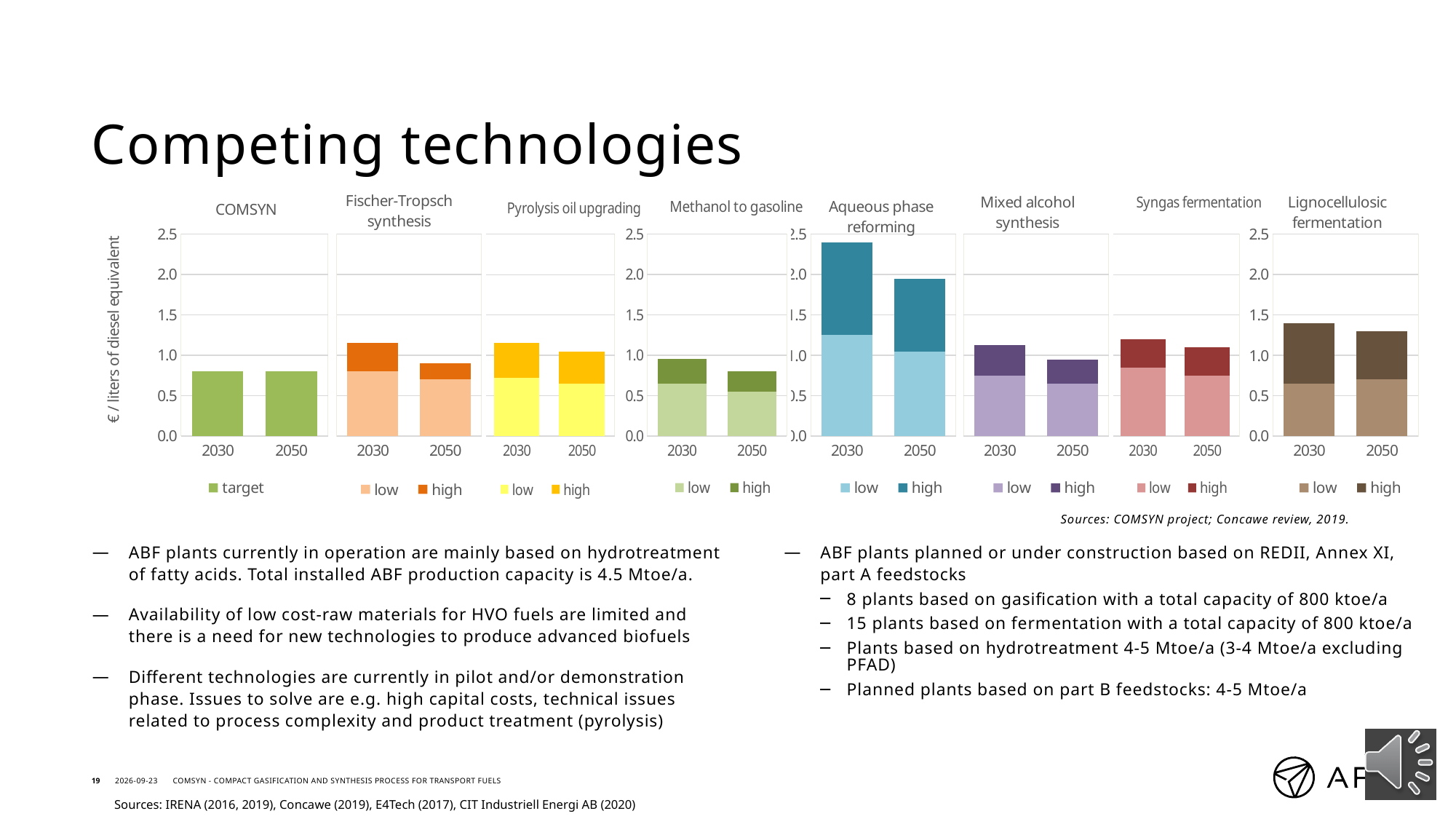
In the Pyrolysis oil upgrading chart, how many year categories are shown on the x axis? 2 In the Fischer-Tropsch synthesis chart, how many series does the legend list? 2 What is the y-axis label shared by the charts? € / liters of diesel equivalent In the COMSYN chart, is the target value for 2030 greater or less than 1.0? less What kind of chart is used for the COMSYN panel? bar chart In the COMSYN chart, how many series does the legend list? 1 In the Fischer-Tropsch synthesis chart, does the total bar height rise or fall from 2030 to 2050? fall In the Aqueous phase reforming chart, is the total height of the 2030 bar greater or less than 2.0? greater What is the single legend entry in the COMSYN chart? target Across all the technology charts, which technology has the tallest 2030 bar? Aqueous phase reforming In the Aqueous phase reforming chart, which year has the taller total bar, 2030 or 2050? 2030 In the Lignocellulosic fermentation chart, is the total height of the 2050 bar greater or less than 1.0? greater